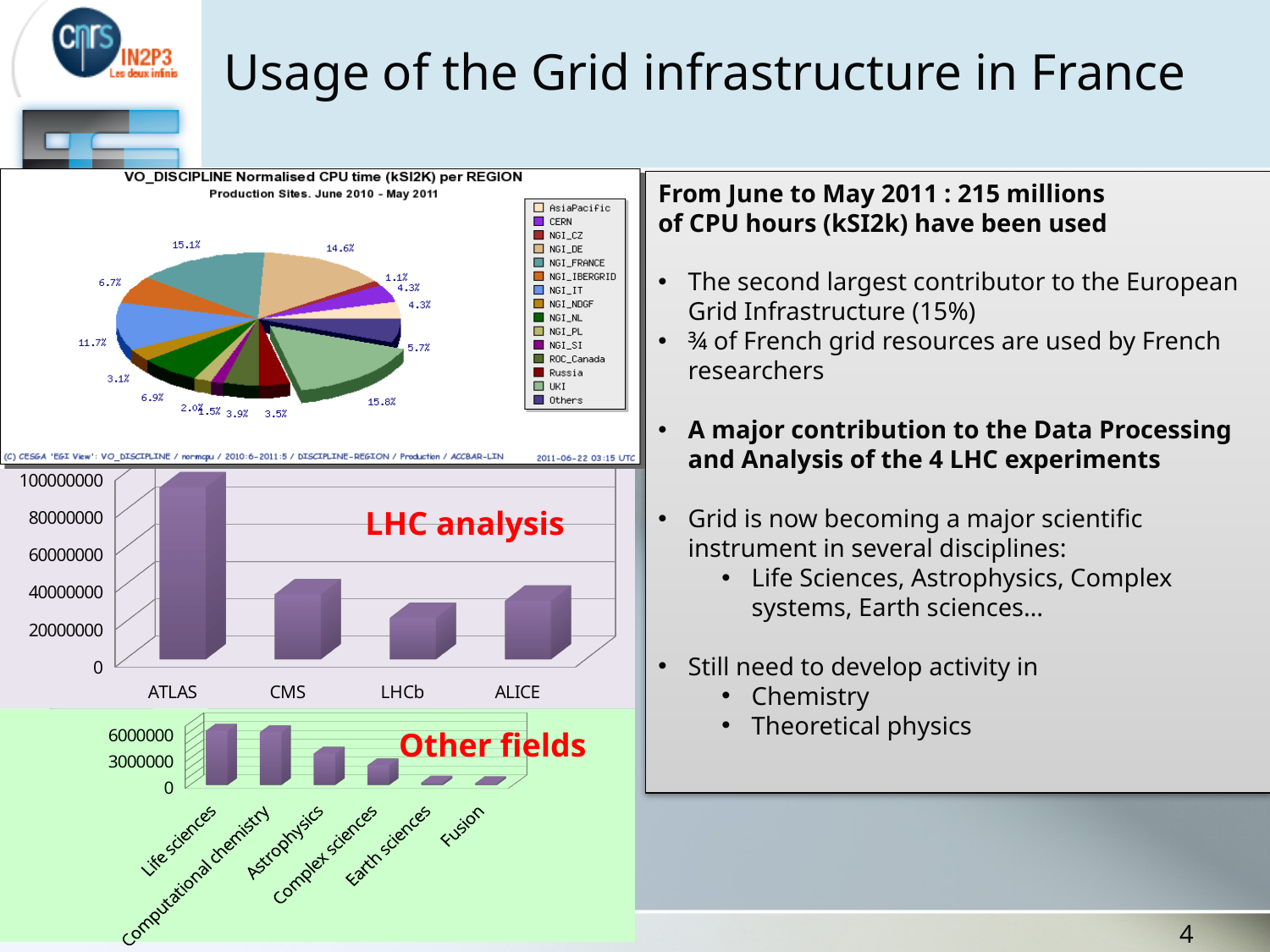
What type of chart is the 'LHC analysis' chart? bar chart In the pie chart 'VO_DISCIPLINE Normalised CPU time (kSI2K) per REGION', what is the largest percentage label shown on a slice? 15.8% In the 'Other fields' chart, is the value for Astrophysics greater or less than 6000000? less What type of chart is the top-left chart titled 'VO_DISCIPLINE Normalised CPU time (kSI2K) per REGION'? pie chart In the 'Other fields' chart, how many categories are shown on the x axis? 6 In the pie chart 'VO_DISCIPLINE Normalised CPU time (kSI2K) per REGION', how many entries does the legend list? 15 In the 'LHC analysis' chart, how many categories are shown on the x axis? 4 In the 'LHC analysis' chart, which is larger, the value for ALICE or the value for LHCb? ALICE In the 'LHC analysis' chart, is the value for LHCb greater or less than 40000000? less In the 'LHC analysis' chart, which experiment has the lowest value? LHCb In the 'LHC analysis' chart, is the value for ATLAS greater or less than 80000000? greater In the 'LHC analysis' chart, which experiment has the highest value? ATLAS